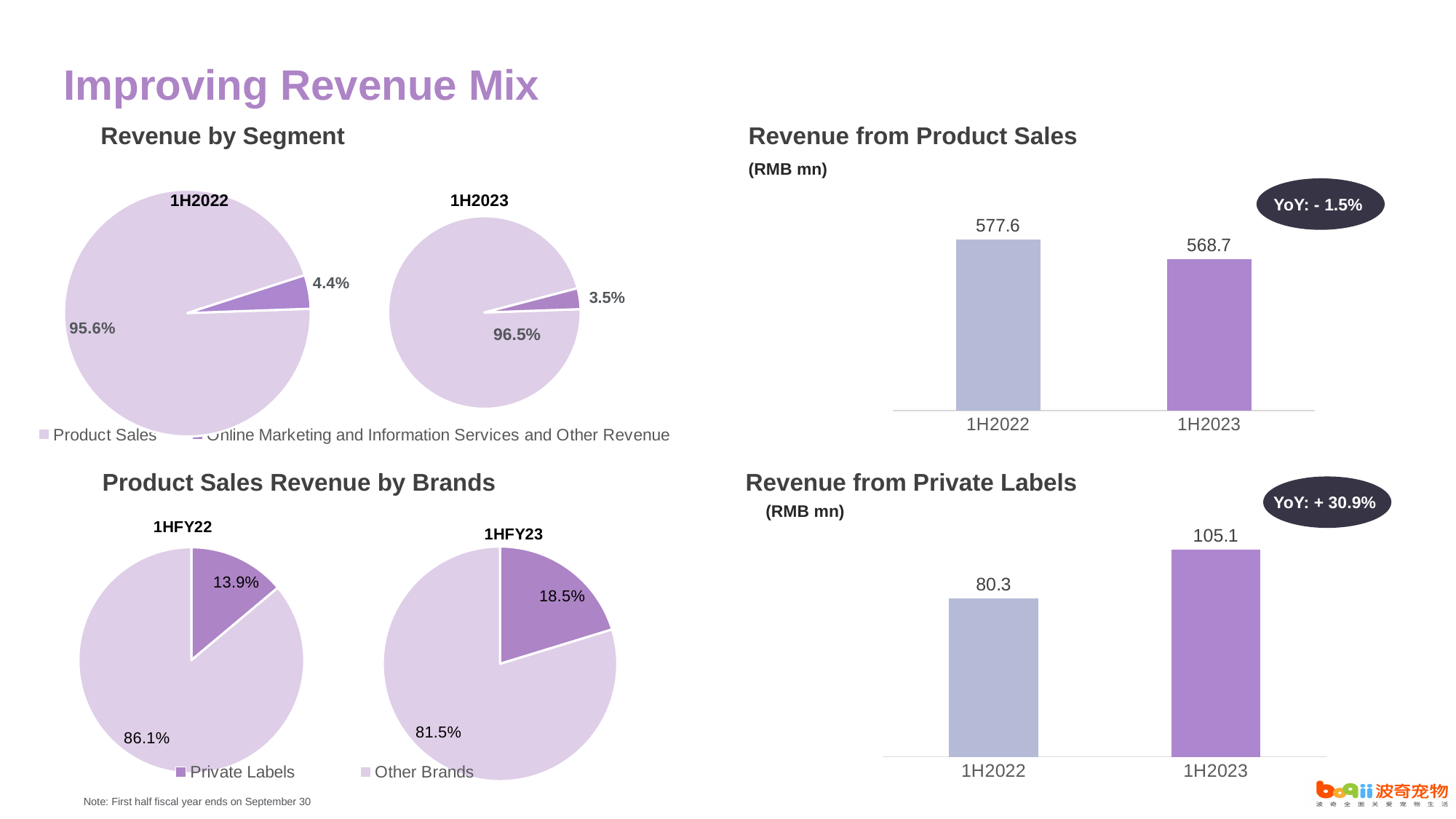
In the 'Product Sales Revenue by Brands' pie chart for 1HFY22, what share is Other Brands? 86.1% In the 'Revenue from Private Labels' bar chart, which period has the higher value? 1H2023 How many series does the legend of the 'Product Sales Revenue by Brands' charts list? 2 In the 'Revenue from Private Labels' bar chart, what is the value for 1H2023? 105.1 In the 'Revenue from Product Sales' bar chart, what is the value for 1H2023? 568.7 What kind of chart is 'Revenue from Private Labels'? bar chart In the 'Revenue from Private Labels' bar chart, what is the difference between the 1H2023 and 1H2022 values? 24.8 In the 'Revenue by Segment' pie chart for 1H2022, what share is Product Sales? 95.6% In the 'Revenue from Product Sales' bar chart, do the values rise or fall from 1H2022 to 1H2023? fall In the 'Revenue by Segment' pie chart for 1H2023, what share is Online Marketing and Information Services and Other Revenue? 3.5% In the 'Revenue from Product Sales' bar chart, what is the value for 1H2022? 577.6